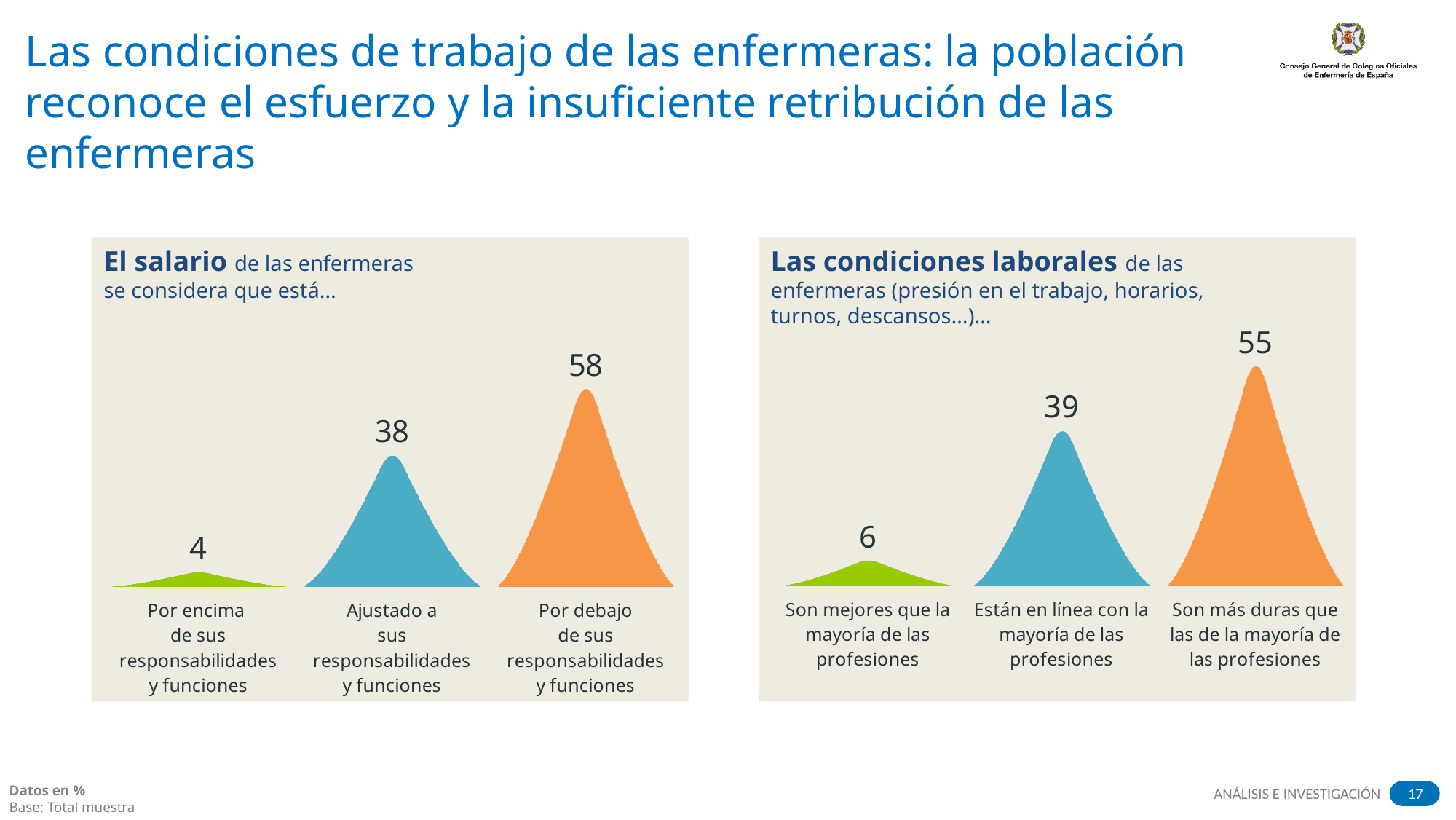
In the left chart (El salario), what percentage considers nurses' salary to be 'Por debajo de sus responsabilidades y funciones'? 58 In the left chart (El salario), what value is shown for 'Por encima de sus responsabilidades y funciones'? 4 In the right chart (Las condiciones laborales), what value is shown for 'Están en línea con la mayoría de las profesiones'? 39 In the right chart (Las condiciones laborales), what is the difference between 'Son más duras' and 'Son mejores'? 49 In the right chart (Las condiciones laborales), what value is shown for 'Son más duras que las de la mayoría de las profesiones'? 55 In the left chart (El salario), what value is shown for 'Ajustado a sus responsabilidades y funciones'? 38 In the left chart (El salario), which category has the highest value? Por debajo de sus responsabilidades y funciones In the right chart (Las condiciones laborales), what value is shown for 'Son mejores que la mayoría de las profesiones'? 6 In the left chart (El salario), which category has the lowest value? Por encima de sus responsabilidades y funciones In the left chart (El salario), what is the difference between 'Por debajo' and 'Ajustado'? 20 How many categories are shown in the right chart (Las condiciones laborales)? 3 In the right chart (Las condiciones laborales), which category has the lowest value? Son mejores que la mayoría de las profesiones